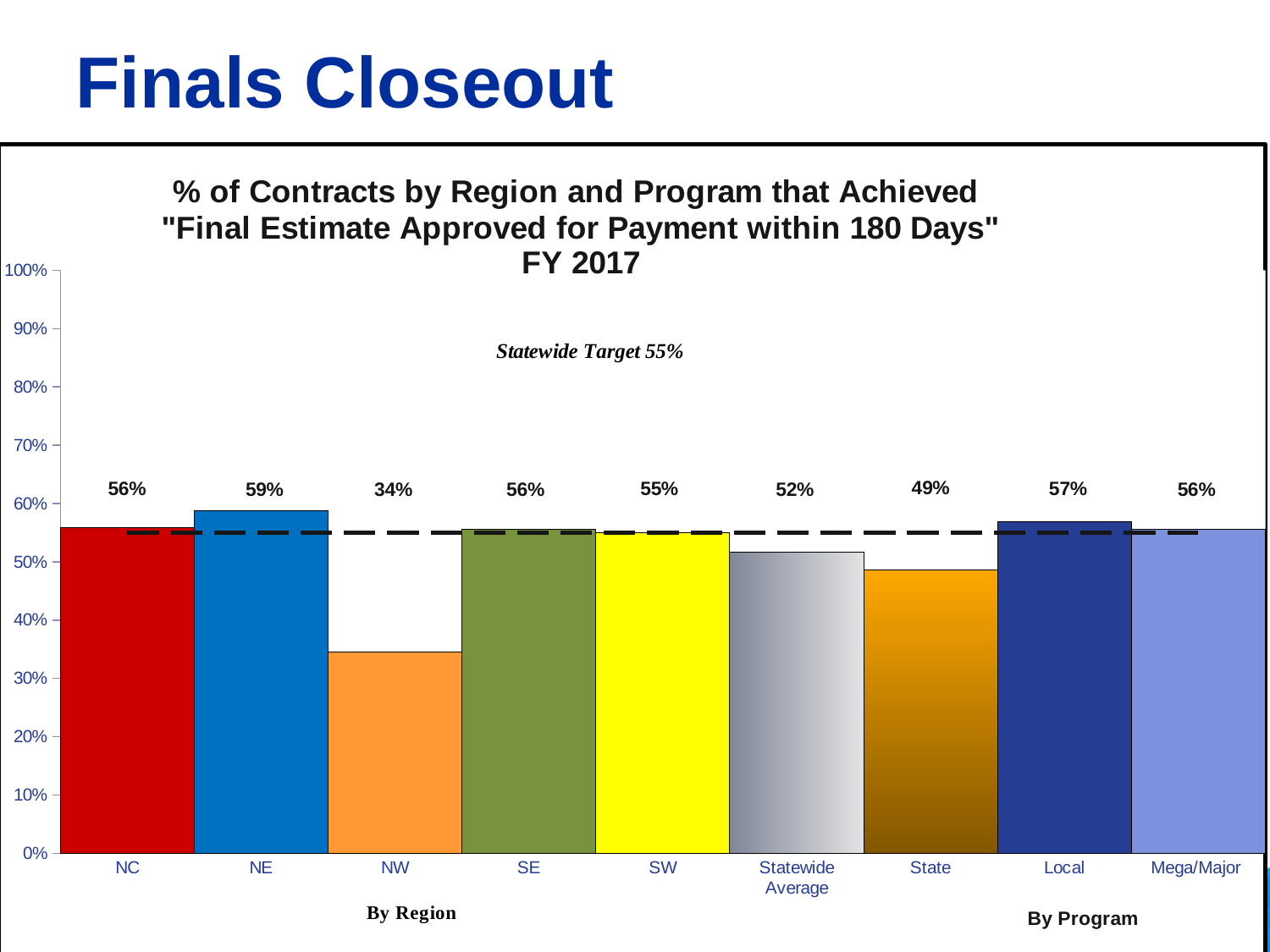
What is the value for NW? 34% What is the Statewide Target shown on the chart? 55% What is the value for Local? 57% How many bars are shown in the chart? 9 What fiscal year does the chart title refer to? FY 2017 Which category has the highest value? NE Which category has the lowest value? NW What is the difference between the values for NE and NW? 25% Is the value for NW greater or less than 40%? less Which is larger, the value for State or the value for Mega/Major? Mega/Major What is the value for the Statewide Average? 52% What kind of chart is shown on the slide? bar chart